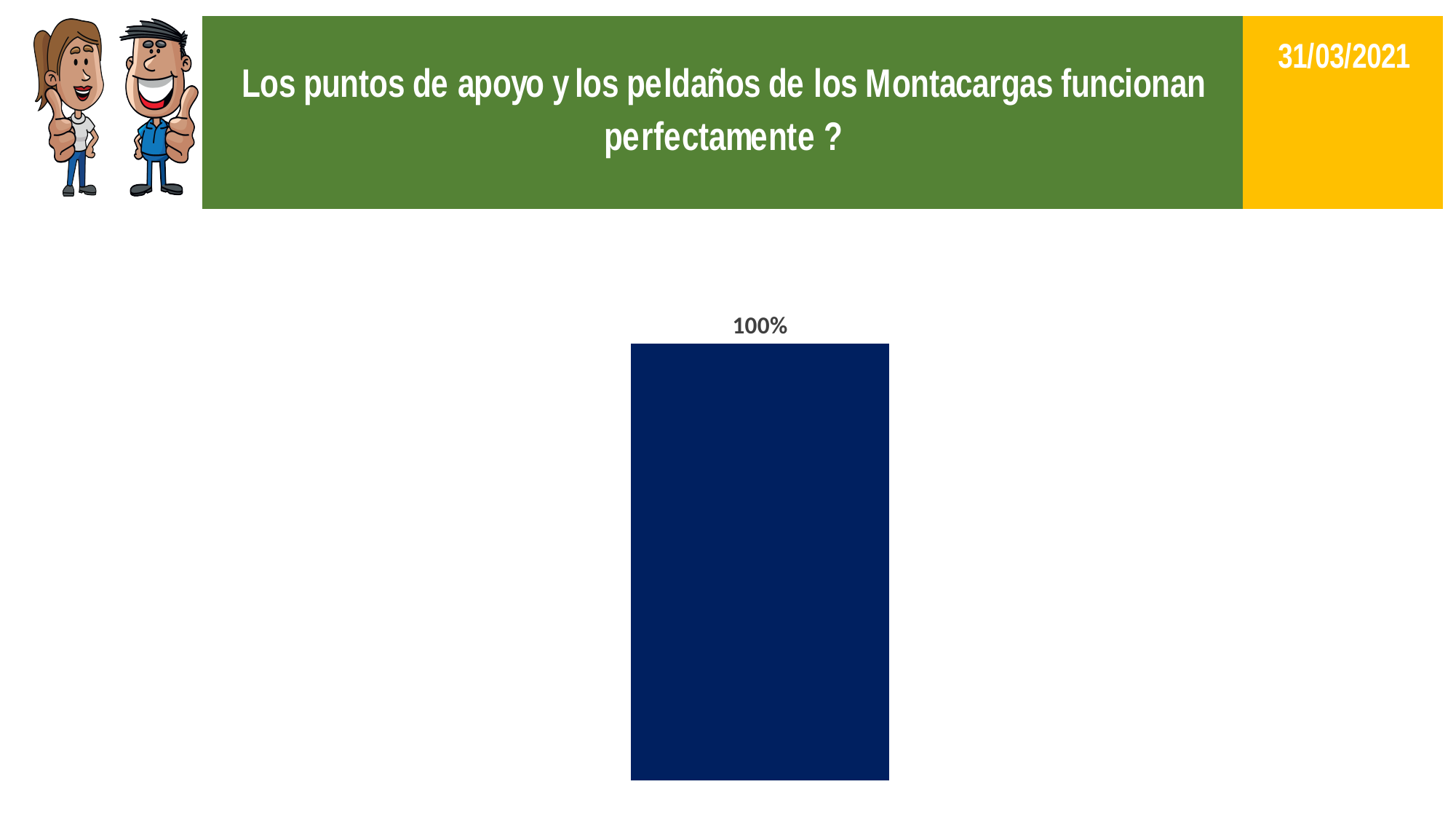
What date is shown in the yellow box at the top right of the slide? 31/03/2021 What kind of chart is shown on the slide? bar chart What colour is the bar in the chart? dark blue What value is printed as the data label on the bar in the chart? 100% How many bars are plotted in the chart? 1